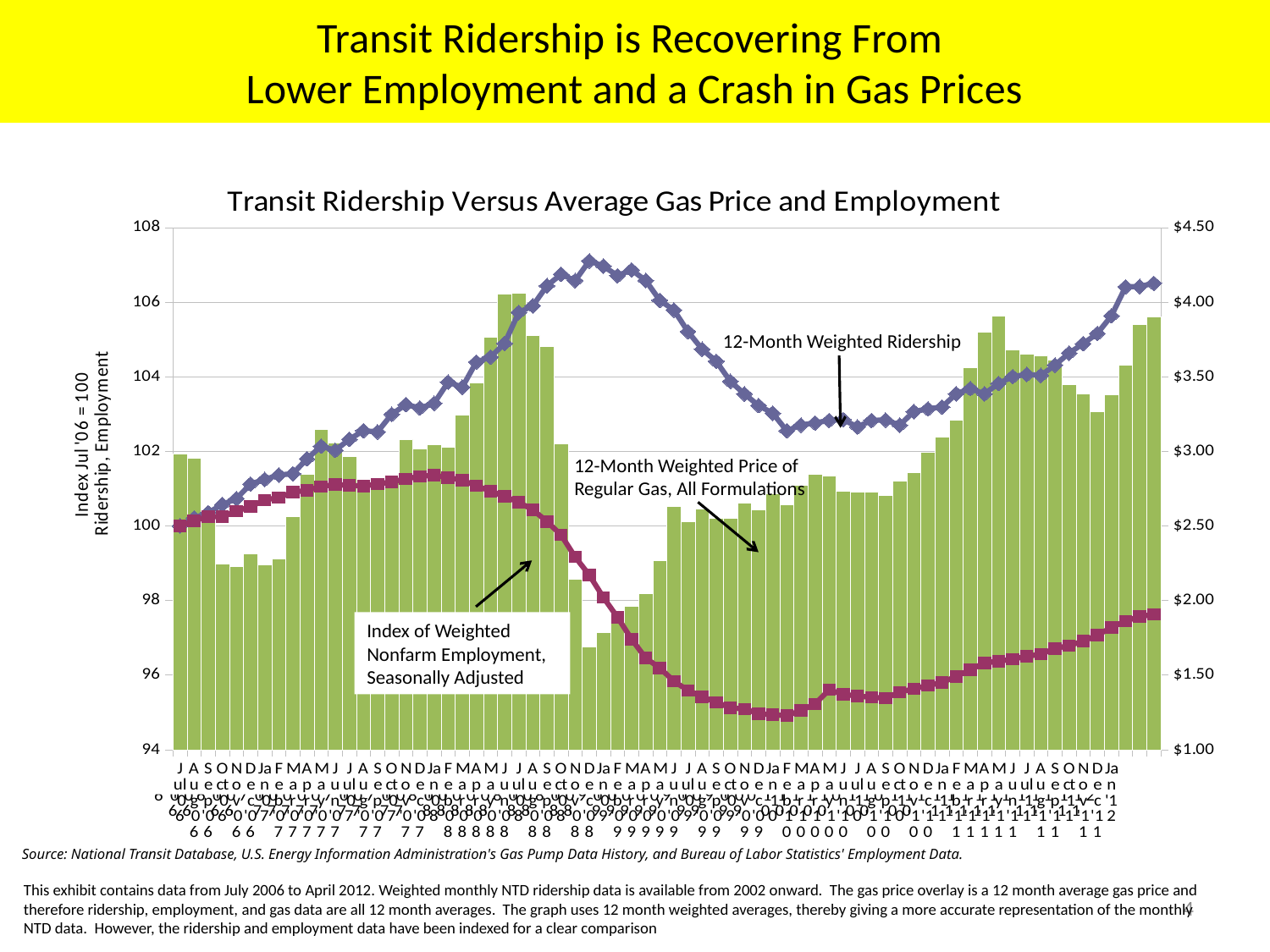
How many data series are annotated on the chart? 3 Is the peak value of the 12-Month Weighted Ridership line greater or less than 106 on the left axis? greater Is the highest gas price bar greater or less than $3.50 on the right axis? greater Which line reaches a higher peak value: 12-Month Weighted Ridership or Index of Weighted Nonfarm Employment? 12-Month Weighted Ridership At the end of the period, which is higher: the 12-Month Weighted Ridership line or the Index of Weighted Nonfarm Employment line? 12-Month Weighted Ridership Is the lowest gas price bar greater or less than $2.50 on the right axis? less What is the title of the chart on the slide? Transit Ridership Versus Average Gas Price and Employment Which series is plotted as green bars? 12-Month Weighted Price of Regular Gas, All Formulations What kind of chart is shown on the slide? A combination chart with bars and two lines Does the 12-Month Weighted Ridership line rise or fall from the start of the period to mid-2008? rise Does the Index of Weighted Nonfarm Employment line rise or fall from mid-2008 to early 2010? fall